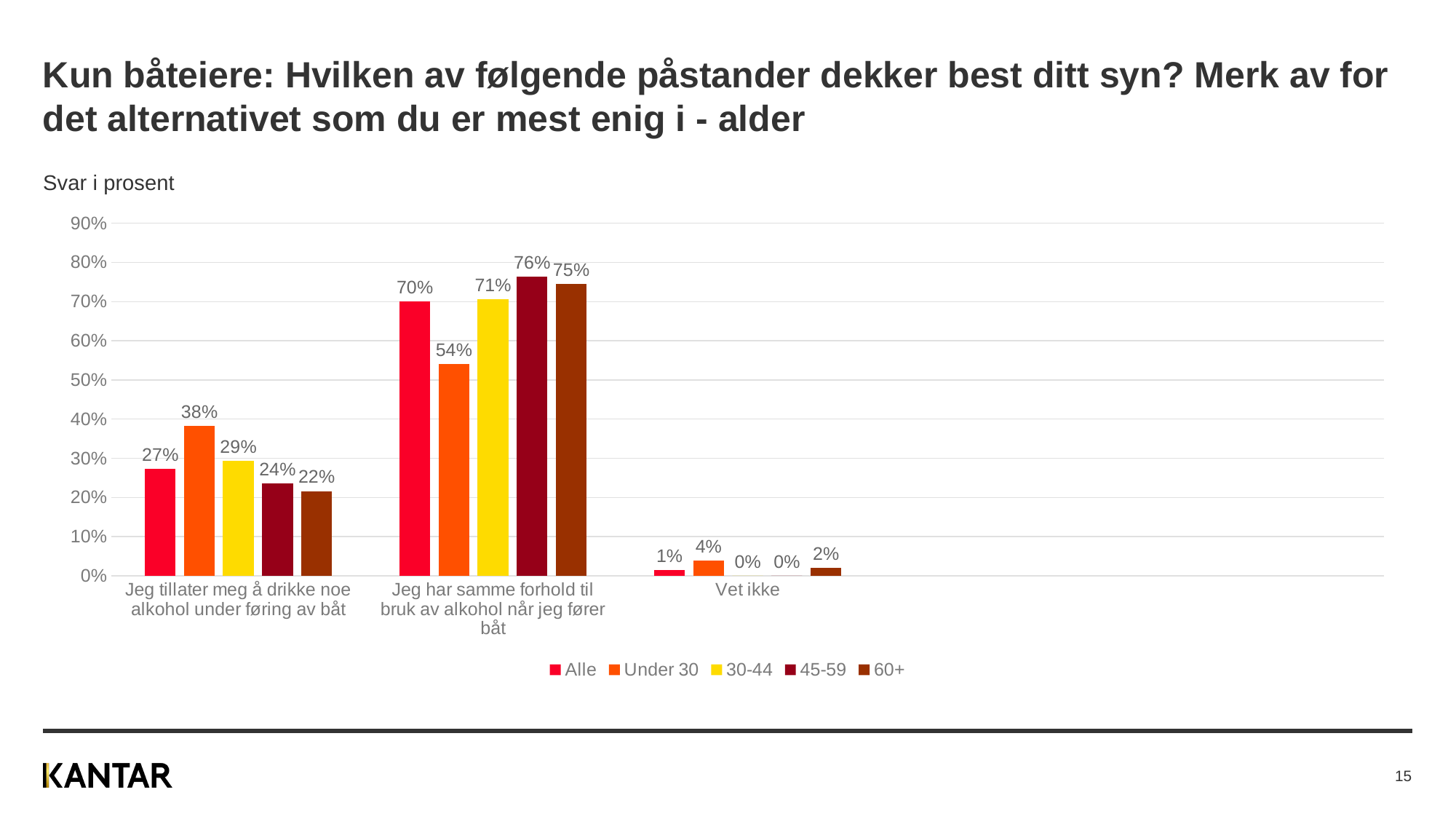
Is the value for '30-44' in the category 'Jeg har samme forhold til bruk av alkohol når jeg fører båt' greater or less than 60%? greater Which series has the lowest value in the category 'Jeg tillater meg å drikke noe alkohol under føring av båt'? 60+ What is the value for 'Under 30' in the category 'Jeg tillater meg å drikke noe alkohol under føring av båt'? 38% How many series does the legend list? 5 Which series has the highest value in the category 'Jeg har samme forhold til bruk av alkohol når jeg fører båt'? 45-59 What is the value for '60+' in the category 'Vet ikke'? 2% How many categories are shown on the x axis? 3 What is the value for '45-59' in the category 'Jeg har samme forhold til bruk av alkohol når jeg fører båt'? 76% What kind of chart is shown on the slide? bar chart What is the subtitle shown above the chart? Svar i prosent What is the difference between the 'Under 30' and '60+' values in the category 'Jeg tillater meg å drikke noe alkohol under føring av båt'? 16% Which is larger: the 'Alle' value or the 'Under 30' value in the category 'Jeg har samme forhold til bruk av alkohol når jeg fører båt'? Alle